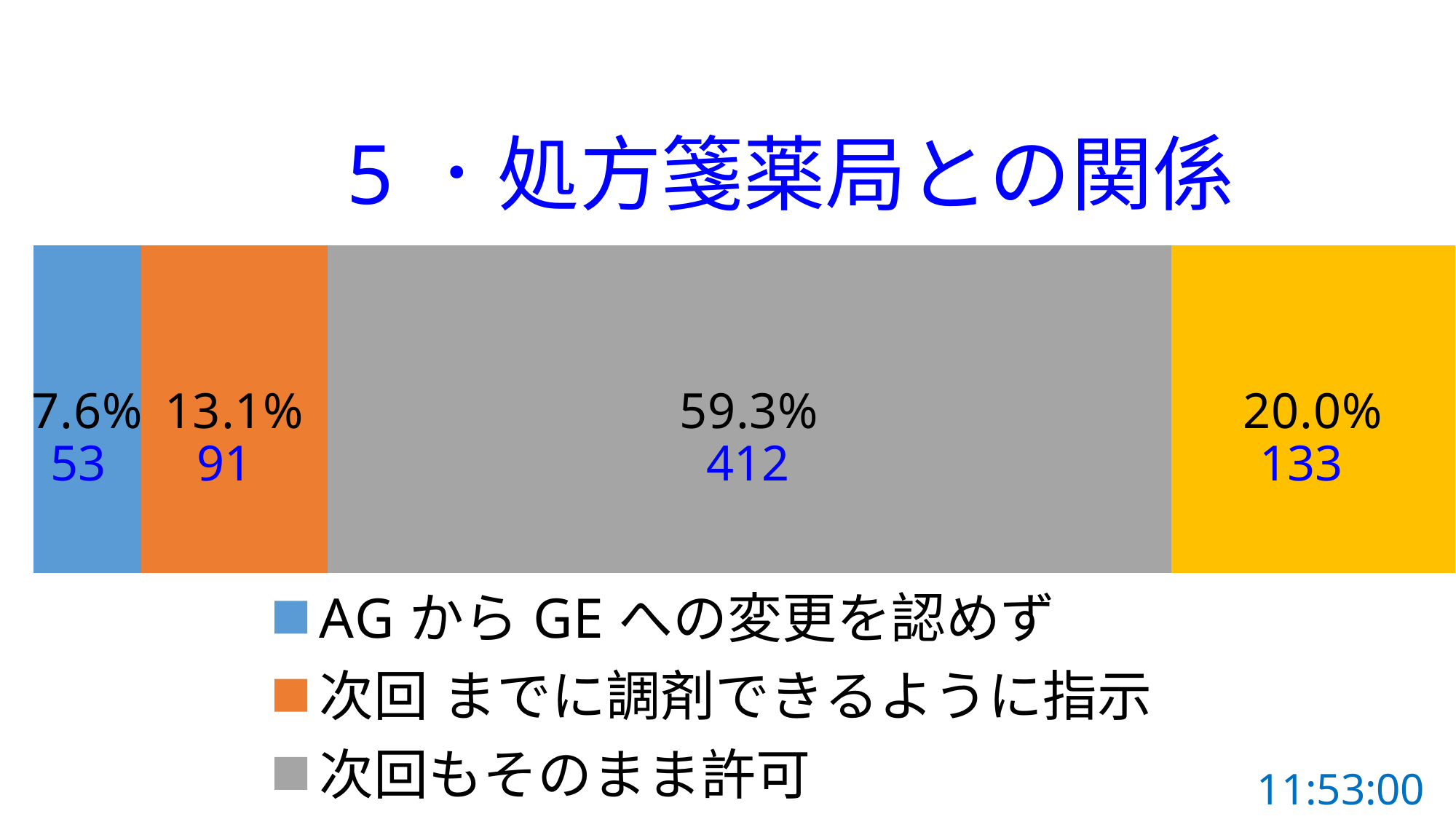
How many entries does the legend list? 3 What percentage is shown for 「次回 までに調剤できるように指示」? 13.1% How many responses are shown for 「次回もそのまま許可」? 412 What is the difference in responses between 「次回もそのまま許可」 and 「次回 までに調剤できるように指示」? 321 Which legend category has the smallest segment in the bar? AG から GE への変更を認めず Which legend category has the largest segment in the bar? 次回もそのまま許可 What is the total number of responses across all segments of the bar? 689 How many responses are shown for 「AG から GE への変更を認めず」? 53 What percentage is shown for 「次回もそのまま許可」? 59.3% Which has more responses: 「次回 までに調剤できるように指示」 or 「AG から GE への変更を認めず」? 次回 までに調剤できるように指示 What kind of chart is shown on the slide? Stacked bar chart How many segments make up the stacked bar? 4